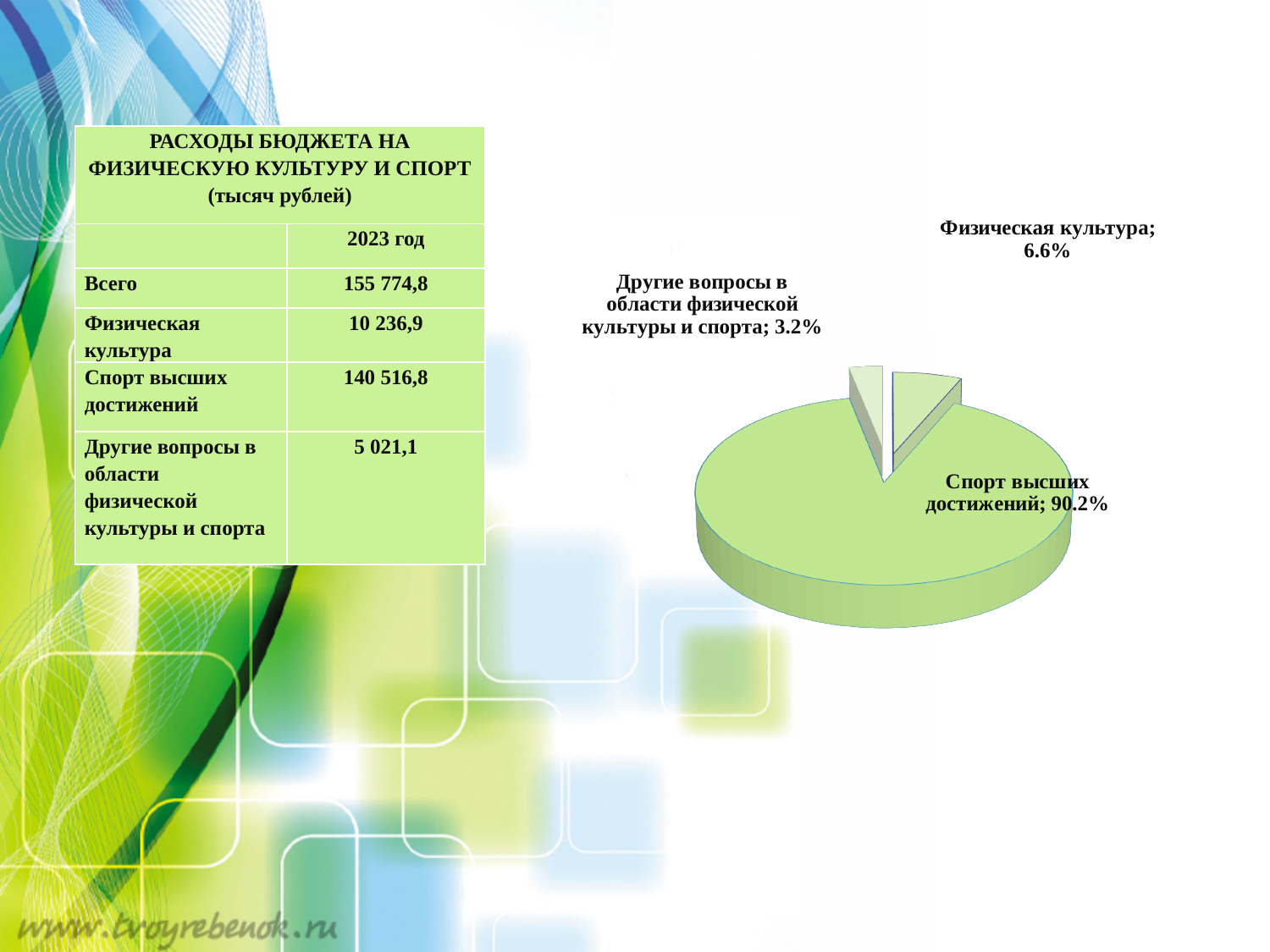
What kind of chart is shown on the slide? pie chart What is the difference in percentage points between the Спорт высших достижений slice and the Физическая культура slice? 83.6 What share of the pie does Физическая культура have? 6.6% Are the slice labels in the pie chart shown with percentages or with absolute values? percentages What share of the pie does Другие вопросы в области физической культуры и спорта have? 3.2% What is the difference in percentage points between the Физическая культура slice and the Другие вопросы в области физической культуры и спорта slice? 3.4 What share of the pie does Спорт высших достижений have? 90.2% Which is larger in the pie chart: Физическая культура or Другие вопросы в области физической культуры и спорта? Физическая культура Is the share for Спорт высших достижений greater or less than 50%? greater Which slice of the pie chart is the largest? Спорт высших достижений How many slices does the pie chart have? 3 Which slice of the pie chart is the smallest? Другие вопросы в области физической культуры и спорта